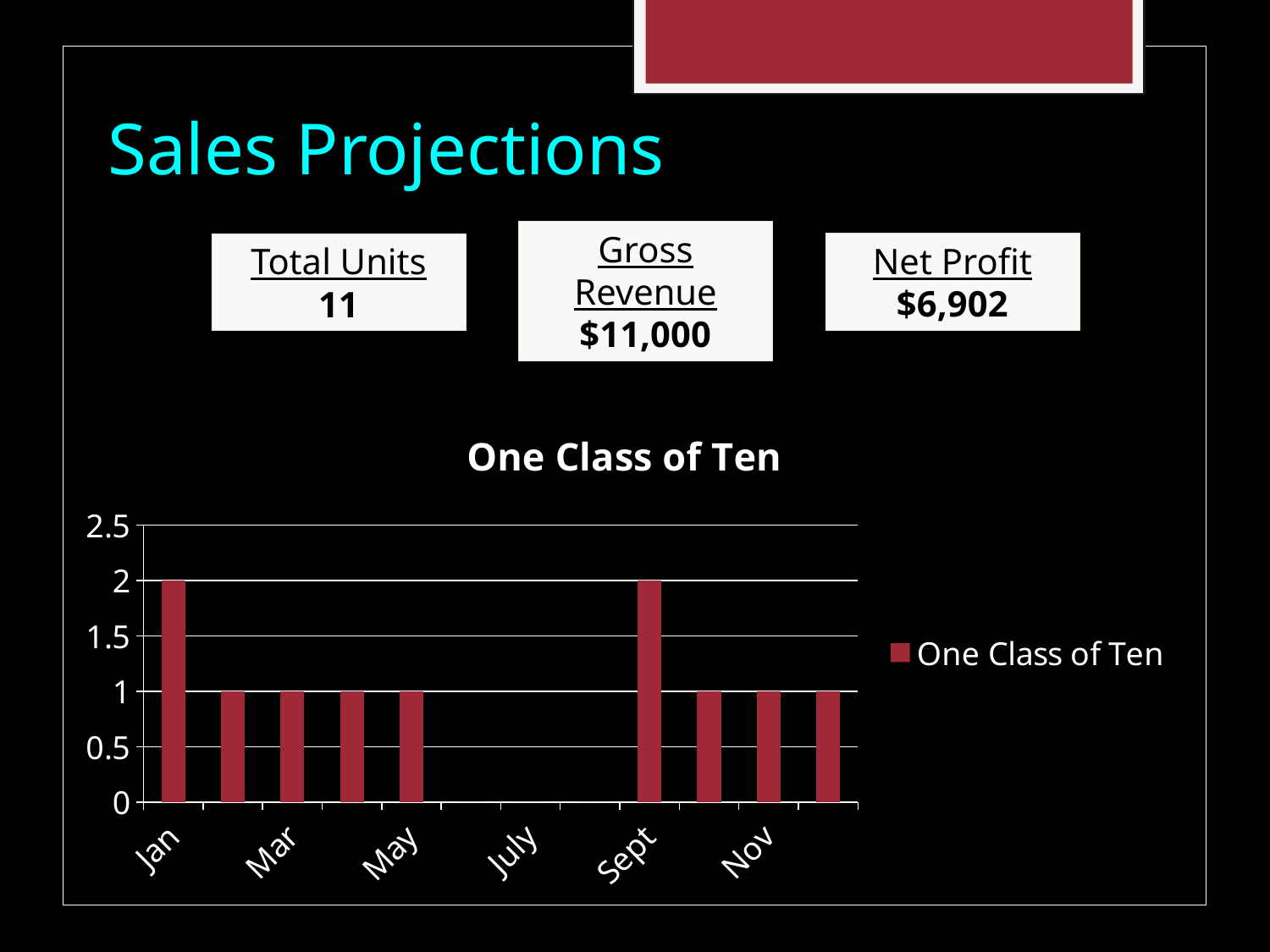
What kind of chart is shown under the title "One Class of Ten"? bar chart What is the legend entry shown in the "One Class of Ten" chart? One Class of Ten How many bars are drawn in the "One Class of Ten" chart? 9 What is the value for Sept in the "One Class of Ten" chart? 2 Is the value for Jan in the "One Class of Ten" chart greater or less than 1.5? greater What is the value for July in the "One Class of Ten" chart? 0 What is the difference between the values for Sept and Nov in the "One Class of Ten" chart? 1 What is the value for Jan in the "One Class of Ten" chart? 2 What is the value for Mar in the "One Class of Ten" chart? 1 Which is larger in the "One Class of Ten" chart, the value for Jan or the value for May? Jan How many series does the legend of the "One Class of Ten" chart list? 1 What is the value for Nov in the "One Class of Ten" chart? 1